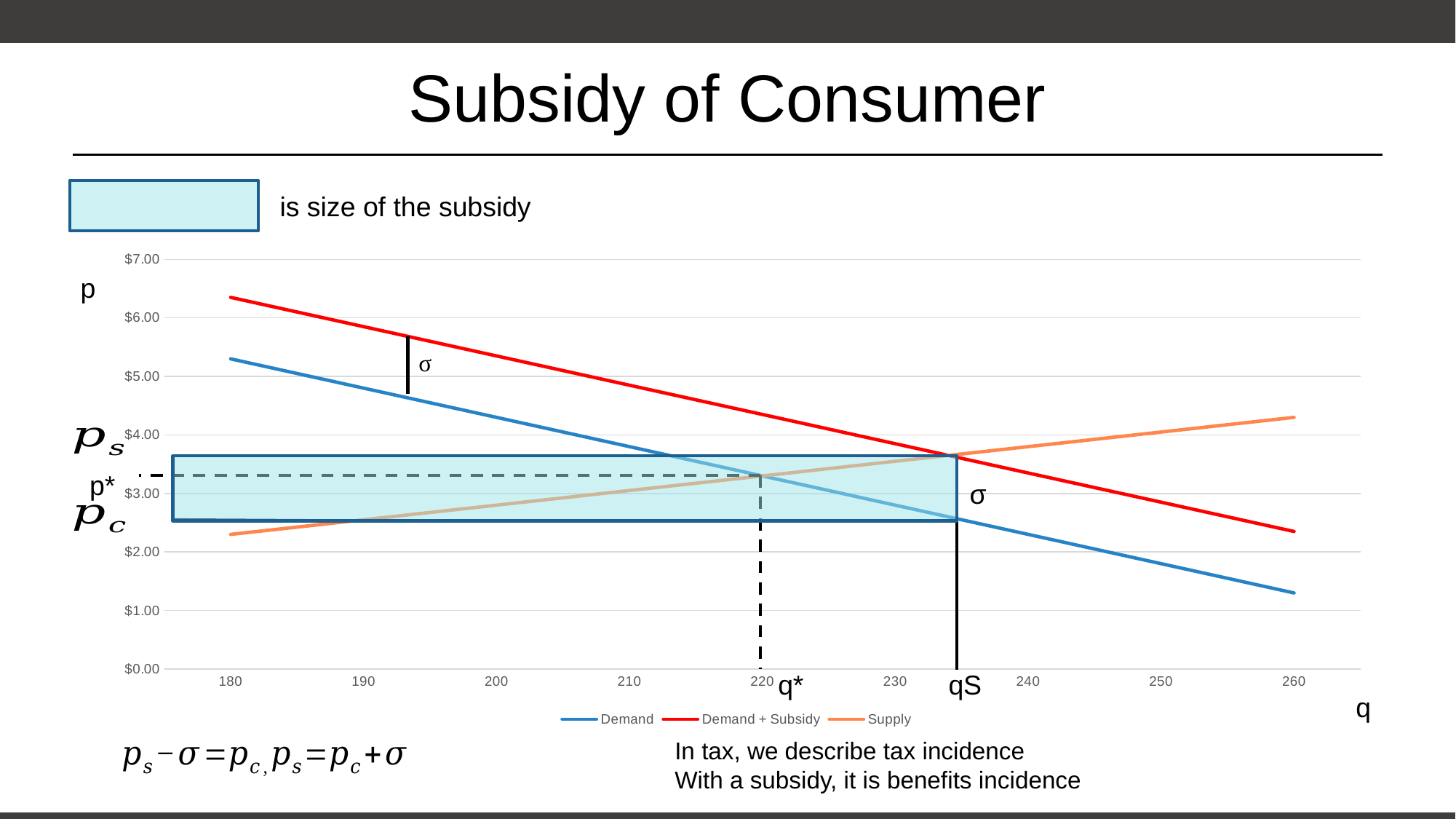
At q = 260, which is larger, the Supply line or the Demand line? Supply Is the value of the Demand line at q = 180 greater or less than $5.00? greater At q = 180, which series has the highest value? Demand + Subsidy What are the three series named in the legend? Demand, Demand + Subsidy, Supply Does the Supply line rise or fall as q increases along the x axis? rise Is the value of the Demand line at q = 260 greater or less than $2.00? less How many series does the chart's legend list? 3 Is the value of the Demand + Subsidy line at q = 180 greater or less than $6.00? greater What colour is the Demand + Subsidy line? red Does the Demand line rise or fall as q increases along the x axis? fall What kind of chart is shown on the slide? line chart